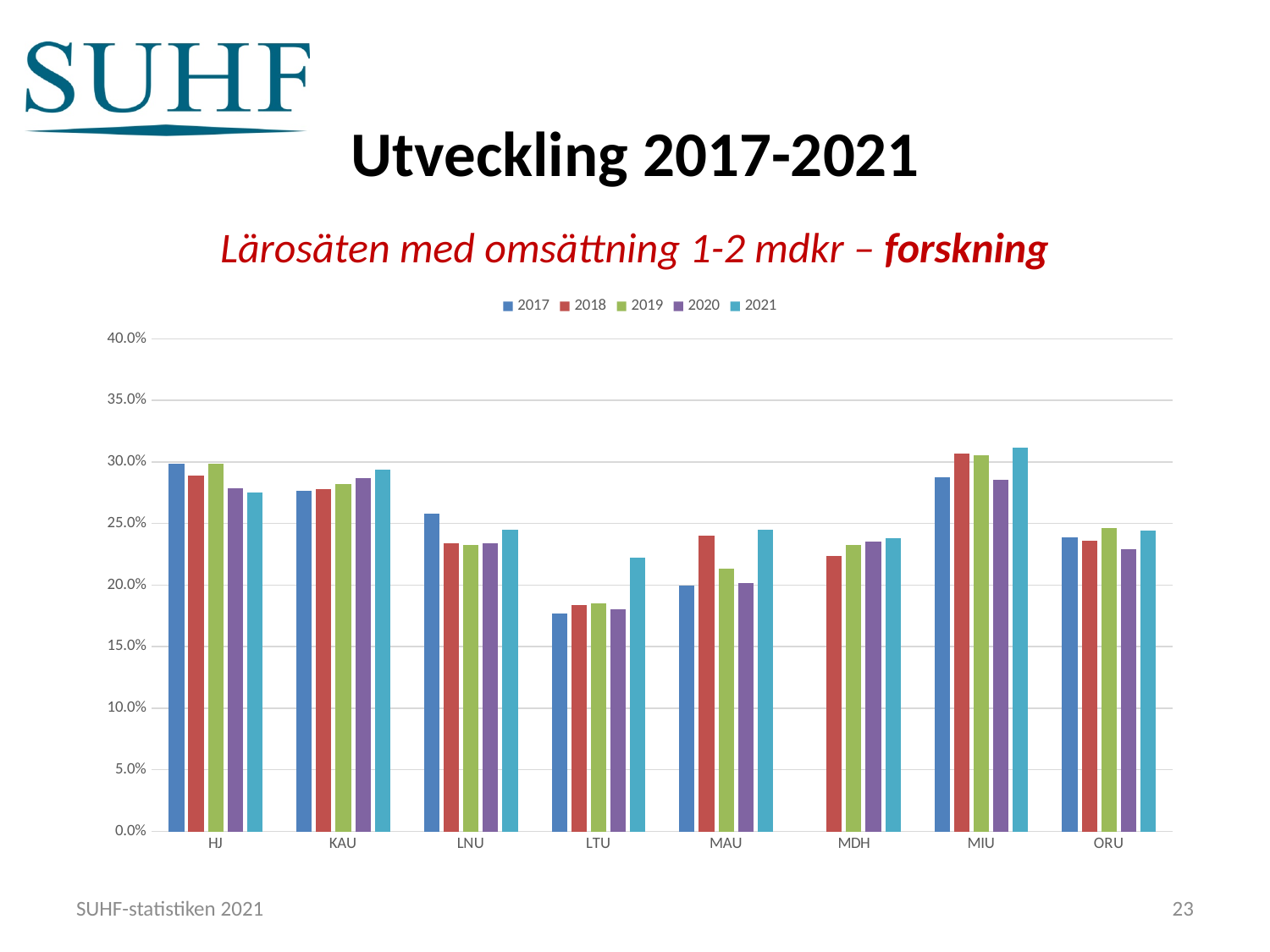
What is the subtitle shown above the chart? Lärosäten med omsättning 1-2 mdkr – forskning For MAU, which is larger: the 2018 value or the 2019 value? 2018 What kind of chart is shown on the slide? bar chart Is the 2021 value for KAU greater or less than 25.0%? greater Which institution has the lowest value for 2017? LTU Is the 2020 value for ORU greater or less than 25.0%? less Is the 2017 value for LTU greater or less than 20.0%? less How many institutions are shown on the x axis? 8 How many years does the legend list? 5 For LTU, which is larger: the 2017 value or the 2021 value? 2021 Which institution has the highest value for 2021? MIU